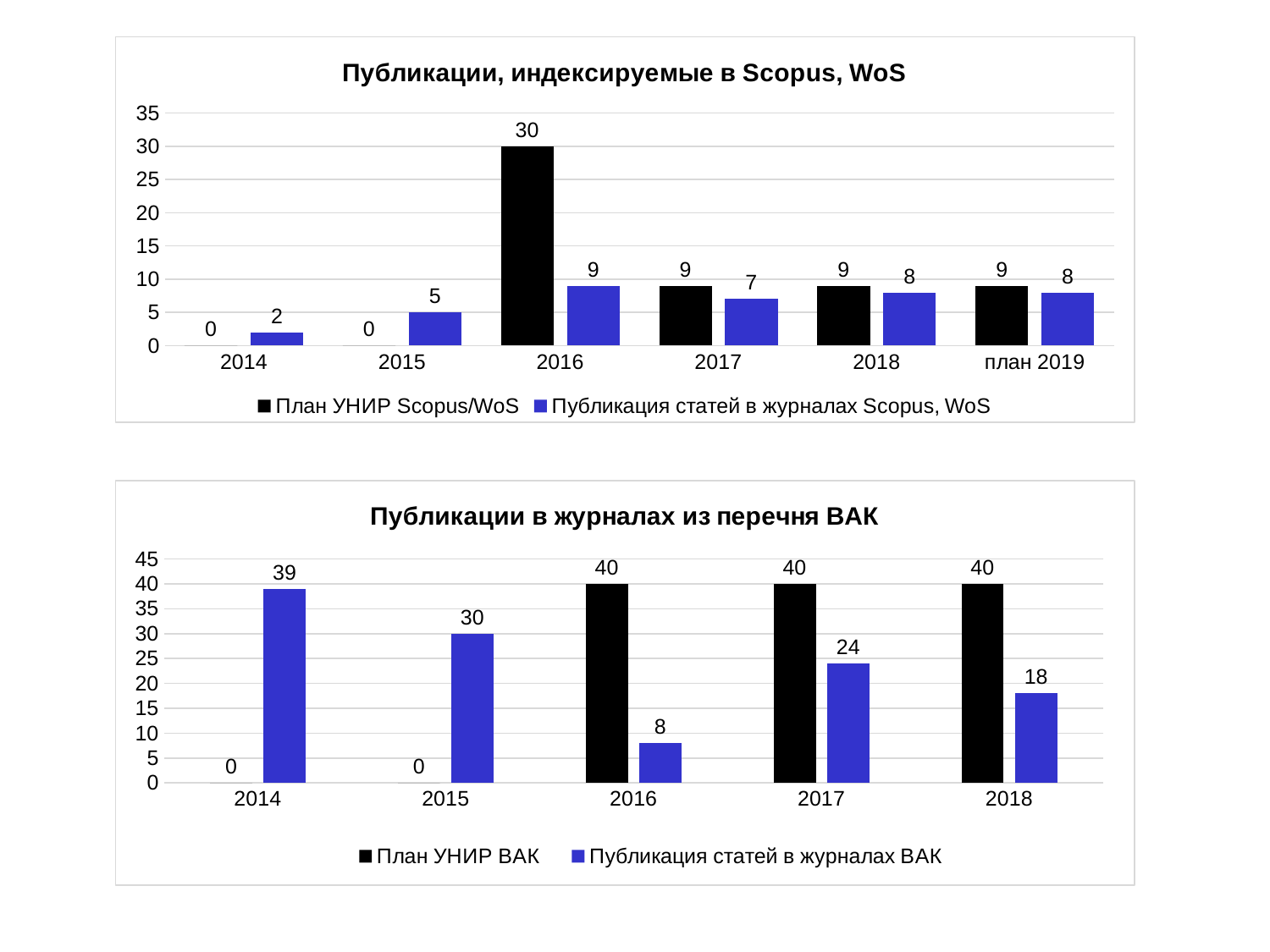
What kind of chart is the bottom chart 'Публикации в журналах из перечня ВАК'? bar chart In the bottom chart 'Публикации в журналах из перечня ВАК', what is the difference between 'План УНИР ВАК' and 'Публикация статей в журналах ВАК' in 2018? 22 In the top chart 'Публикации, индексируемые в Scopus, WoS', how many categories are shown on the x axis? 6 In the top chart 'Публикации, индексируемые в Scopus, WoS', what is the value of 'Публикация статей в журналах Scopus, WoS' for 2017? 7 In the bottom chart 'Публикации в журналах из перечня ВАК', which is larger: 'Публикация статей в журналах ВАК' in 2017 or in 2018? 2017 In the bottom chart 'Публикации в журналах из перечня ВАК', what is the value of 'Публикация статей в журналах ВАК' for 2014? 39 In the bottom chart 'Публикации в журналах из перечня ВАК', which year has the lowest value for 'Публикация статей в журналах ВАК'? 2016 In the top chart 'Публикации, индексируемые в Scopus, WoS', what is the value of 'План УНИР Scopus/WoS' for 2016? 30 In the top chart 'Публикации, индексируемые в Scopus, WoS', how many series does the legend list? 2 In the top chart 'Публикации, индексируемые в Scopus, WoS', which year has the highest value for 'Публикация статей в журналах Scopus, WoS'? 2016 In the bottom chart 'Публикации в журналах из перечня ВАК', what colour are the bars for 'План УНИР ВАК'? black In the top chart 'Публикации, индексируемые в Scopus, WoS', what is the difference between 'План УНИР Scopus/WoS' and 'Публикация статей в журналах Scopus, WoS' in 2016? 21